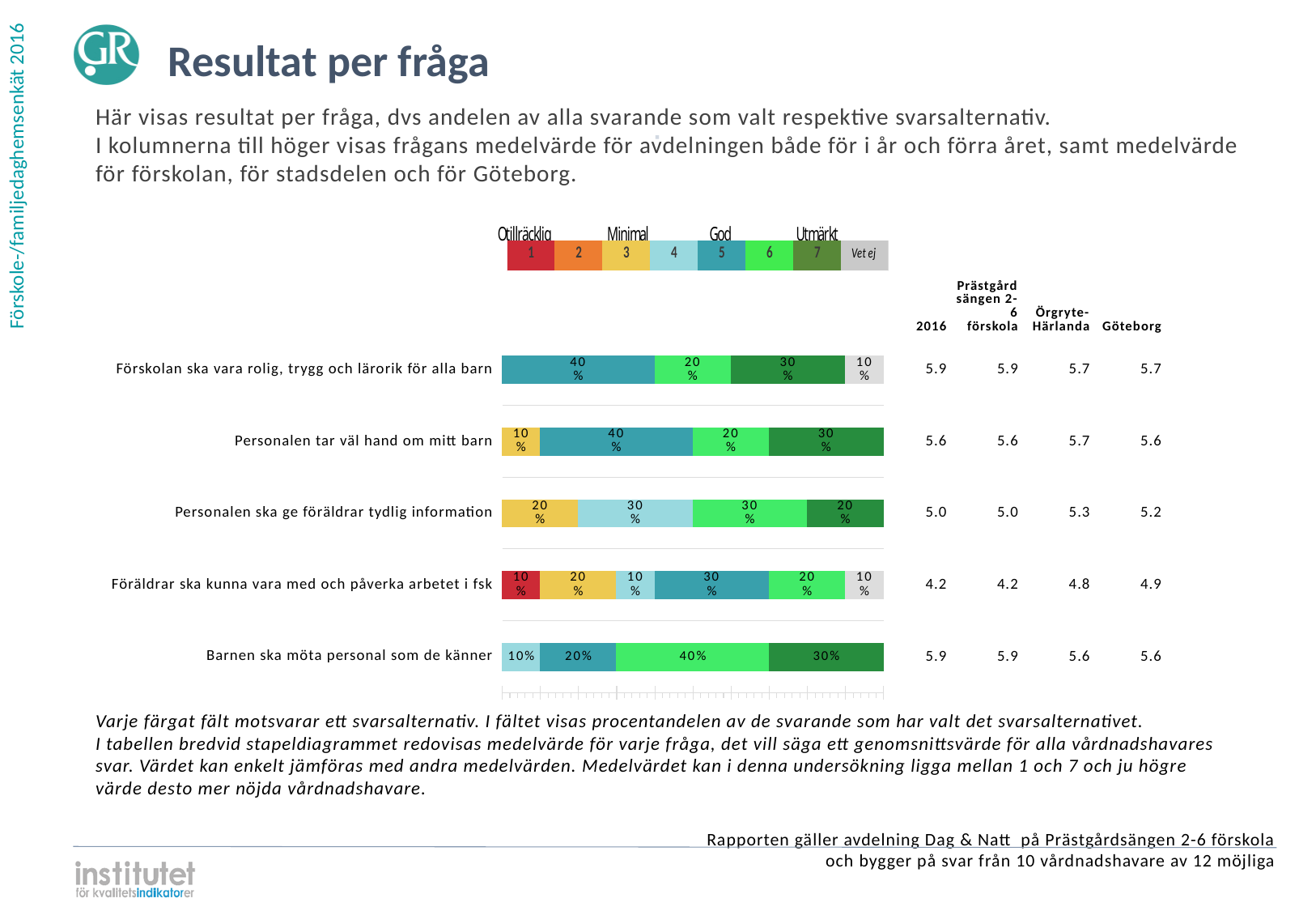
What percentage of respondents chose answer 5 for 'Personalen tar väl hand om mitt barn'? 40% What percentage of respondents chose answer 6 for 'Barnen ska möta personal som de känner'? 40% For 'Personalen ska ge föräldrar tydlig information', what is the difference between the share choosing answer 4 and the share choosing answer 7? 10% How many answer alternatives does the legend above the chart list? 8 What percentage of respondents chose answer 1 (Otillräcklig) for 'Föräldrar ska kunna vara med och påverka arbetet i fsk'? 10% How many questions (categories) are plotted in the bar chart? 5 For 'Barnen ska möta personal som de känner', which is larger: the share choosing answer 6 or the share choosing answer 7? Answer 6 What kind of chart is shown on the slide? Stacked bar chart What percentage of respondents chose answer 7 (Utmärkt) for 'Förskolan ska vara rolig, trygg och lärorik för alla barn'? 30% What is the 2016 mean value shown for 'Föräldrar ska kunna vara med och påverka arbetet i fsk'? 4.2 Which answer alternative has the largest share for 'Personalen tar väl hand om mitt barn'? 5 What colour represents answer alternative 1 (Otillräcklig) in the legend? Red